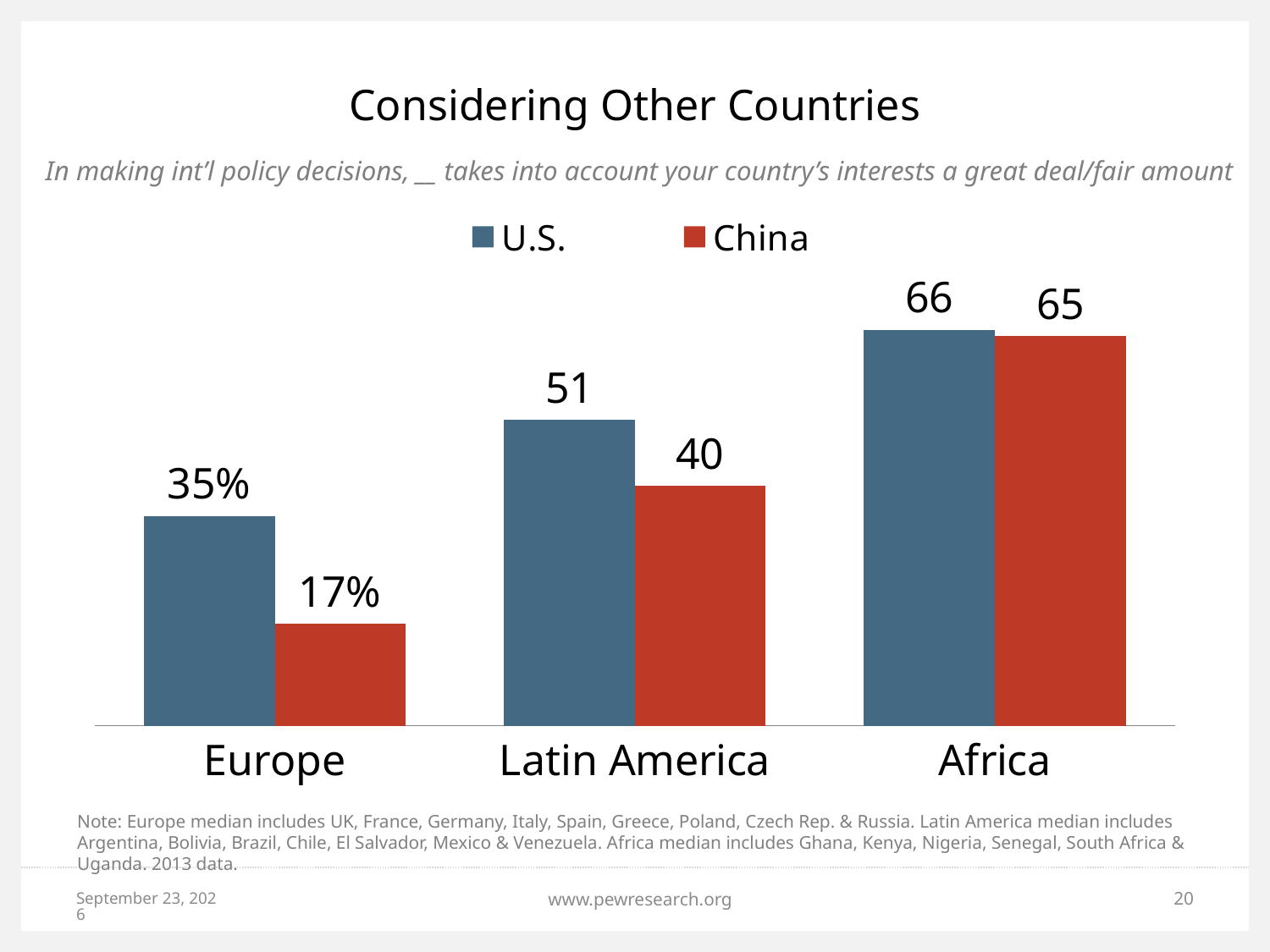
How many regions are shown on the x axis? 3 What is the China value for Africa? 65 Which region has the highest U.S. value? Africa Which region has the lowest China value? Europe What is the China value for Latin America? 40 What is the difference between the U.S. values for Africa and Latin America? 15 Do the China values rise or fall from Europe to Africa? Rise What is the difference between the U.S. and China values for Europe? 18 Which is larger for Latin America, the U.S. value or the China value? U.S. What is the U.S. value for Europe? 35% How many series does the legend list? 2 What kind of chart is shown on the slide? Bar chart